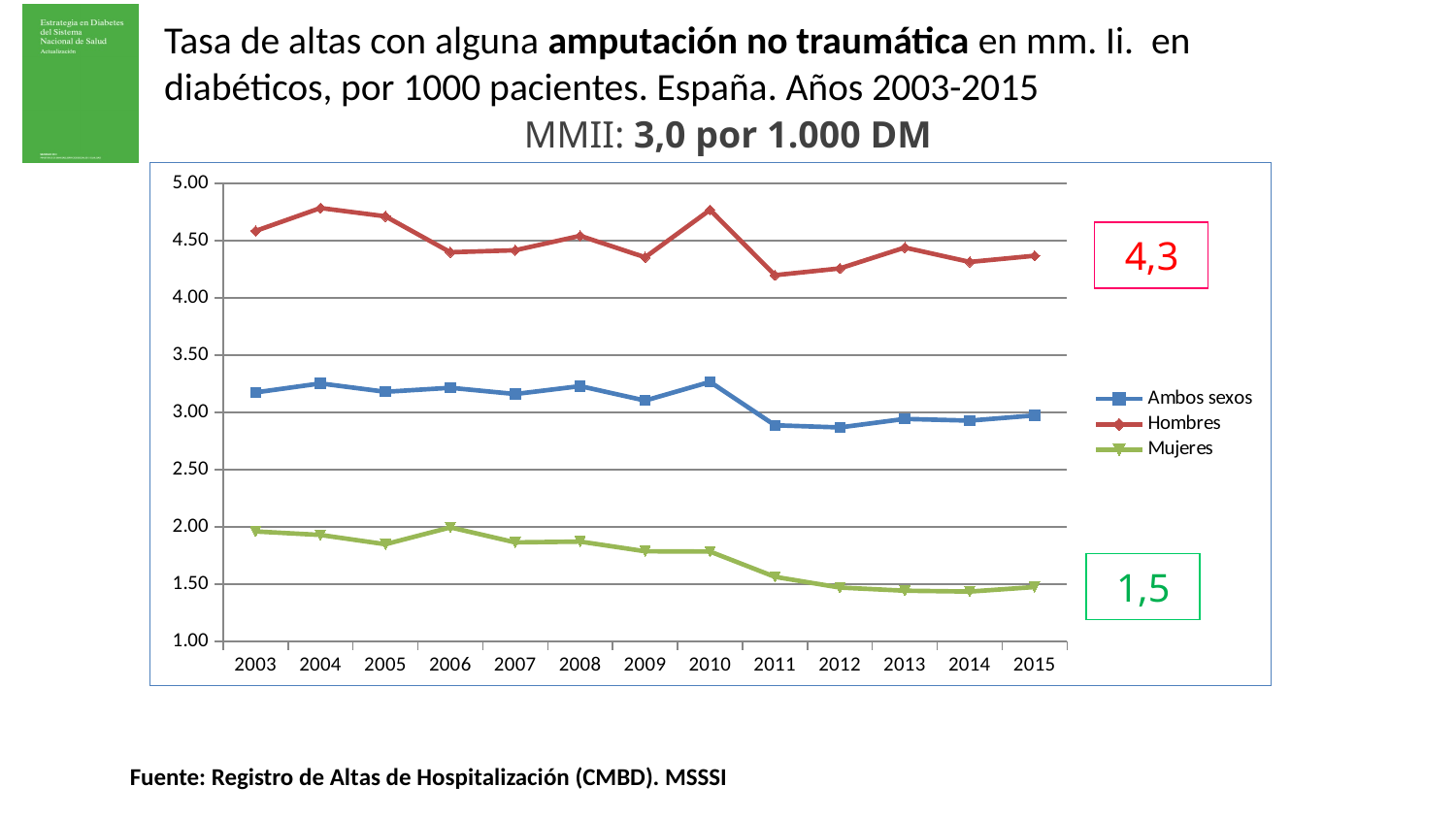
Which is larger for Ambos sexos, the value in 2010 or the value in 2011? 2010 How many series does the legend list? 3 Is the value for Hombres in 2004 greater or less than 4.50? greater Is the value for Mujeres in 2013 greater or less than 1.50? less What kind of chart is shown on the slide? line chart Do the values for Mujeres rise or fall from 2003 to 2015? fall How many years are shown on the x axis? 13 Is the value for Ambos sexos in 2011 greater or less than 3.00? less What are the three entries in the chart legend? Ambos sexos, Hombres, Mujeres Which series has the highest values across all years? Hombres Which series has the lowest values across all years? Mujeres